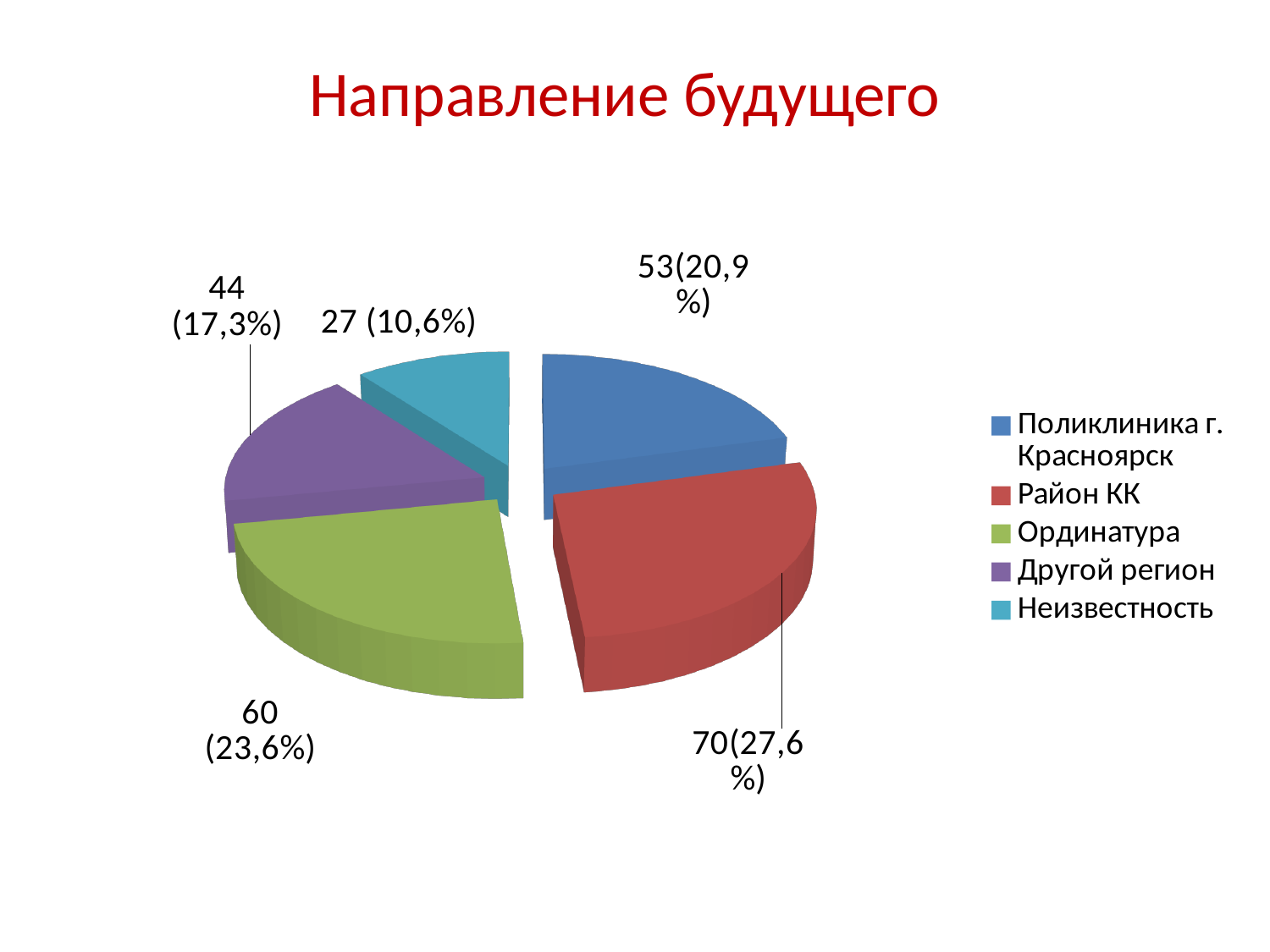
Which category has the largest slice? Район КК What share of the pie does Другой регион represent? 17,3% Which category has the smallest slice? Неизвестность What share of the pie does Ординатура represent? 23,6% What is the title of the chart? Направление будущего What is the difference between the values for Район КК and Ординатура? 10 Which is larger, the value for Поликлиника г. Красноярск or the value for Другой регион? Поликлиника г. Красноярск What type of chart is shown on the slide? pie chart What is the value for Неизвестность? 27 How many categories does the legend list? 5 What is the value for Район КК? 70 What is the value for Поликлиника г. Красноярск? 53